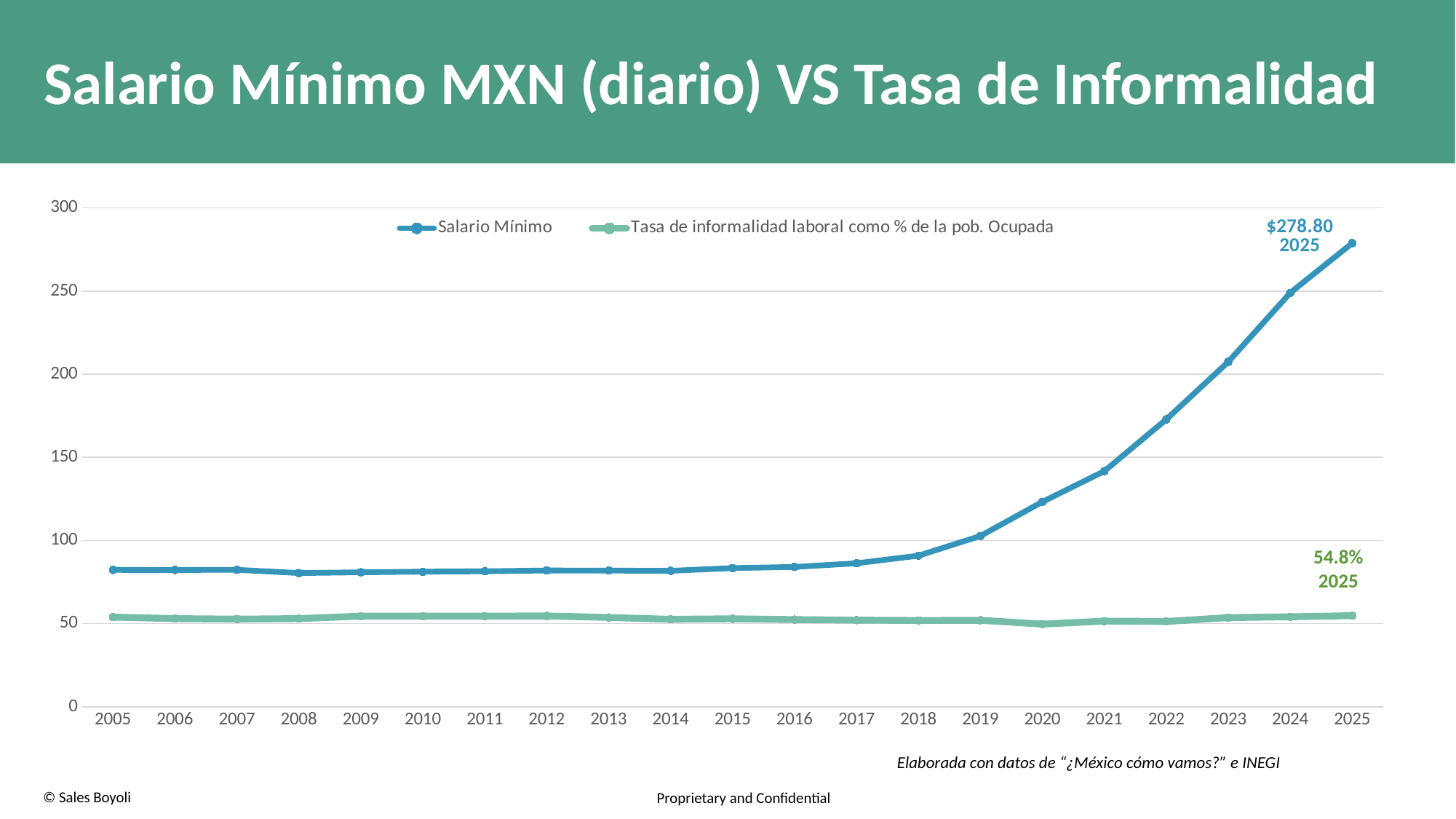
Does Salario Mínimo rise or fall from 2018 to 2025? Rise What kind of chart is shown on the slide? Line chart In which year is Salario Mínimo highest? 2025 In which year is Tasa de informalidad laboral como % de la pob. Ocupada lowest? 2020 What is the title of the slide? Salario Mínimo MXN (diario) VS Tasa de Informalidad How many years are plotted along the x axis? 21 How many series does the legend list? 2 Is the value for Salario Mínimo in 2010 greater or less than 100? less What is the value of Salario Mínimo in 2025? $278.80 Is the value for Salario Mínimo in 2020 greater or less than 100? greater Is the value for Salario Mínimo in 2022 greater or less than 150? greater What is the value of Tasa de informalidad laboral como % de la pob. Ocupada in 2025? 54.8%